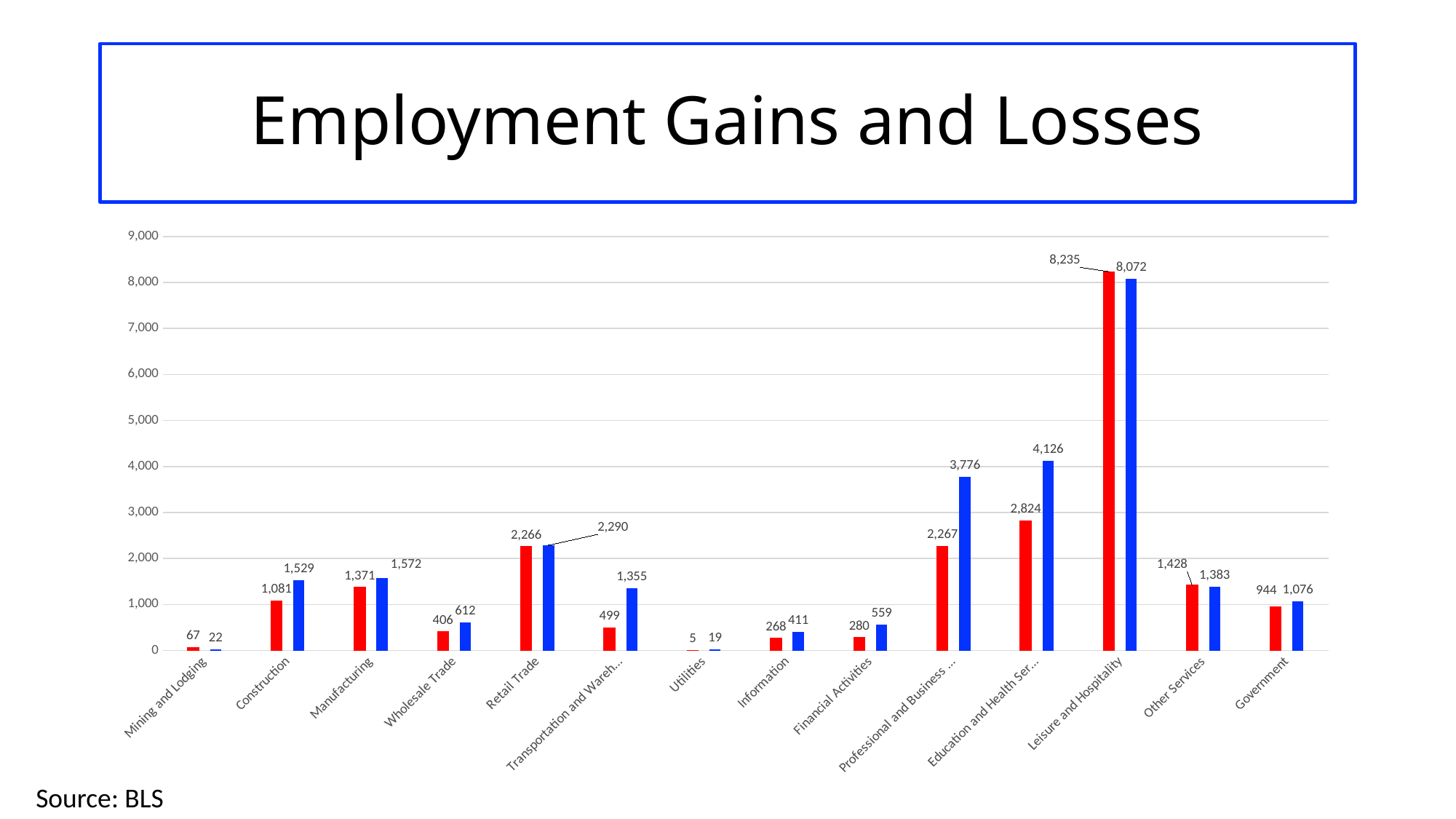
What is the difference between the blue bar and the red bar for Wholesale Trade? 206 What is the value of the red bar for Leisure and Hospitality? 8,235 What is the value of the blue bar for Manufacturing? 1,572 What kind of chart is shown on the slide? bar chart What is the title of the slide? Employment Gains and Losses Is the value of the blue bar for Financial Activities greater or less than 1,000? less What is the value of the blue bar for Government? 1,076 Which category has the lowest blue bar? Utilities Which category has the highest red bar? Leisure and Hospitality For Other Services, which is larger, the red bar or the blue bar? the red bar What is the value of the red bar for Construction? 1,081 How many categories are shown on the x axis? 14